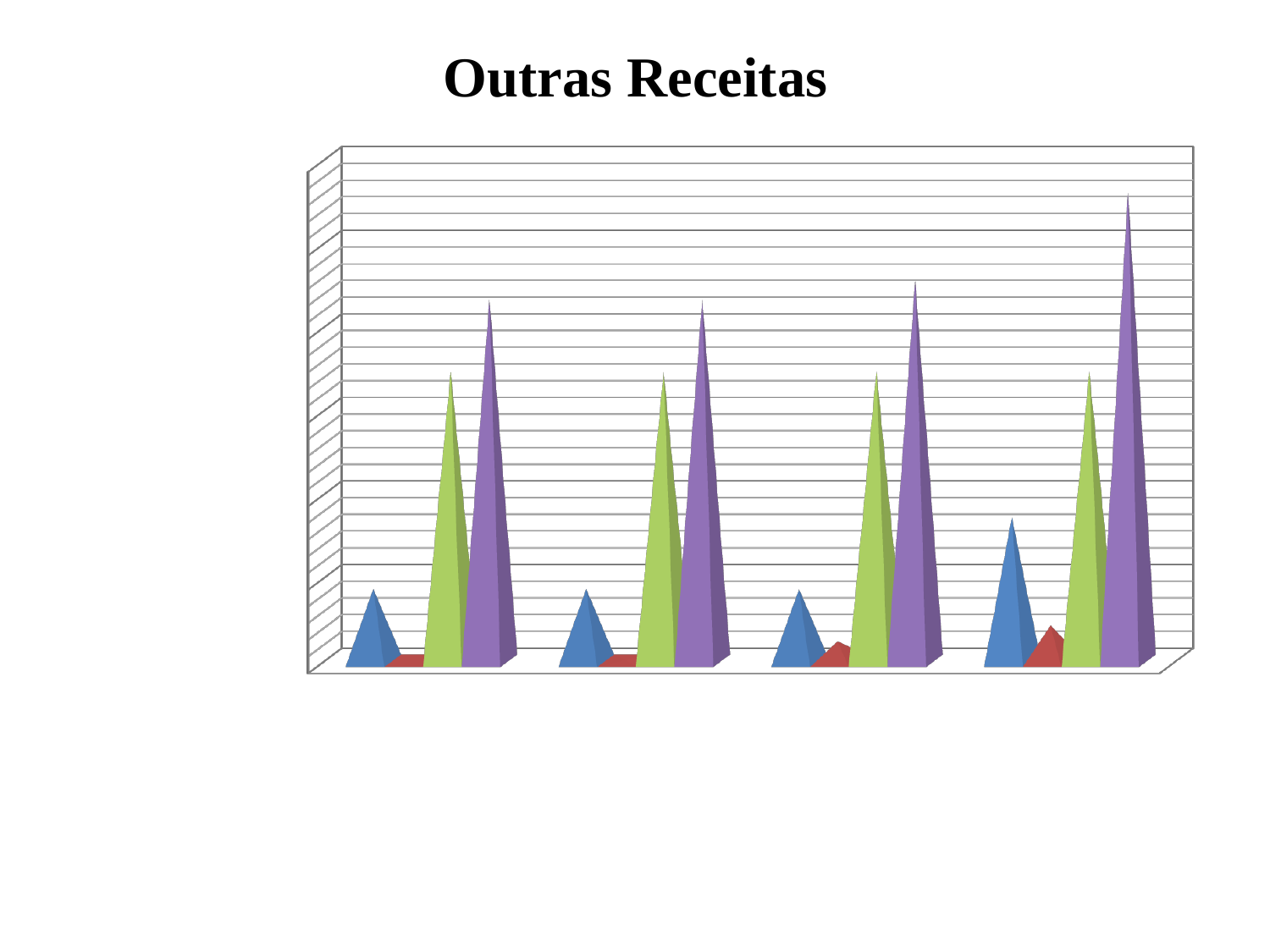
Which coloured series has the shortest bar in the leftmost group? red What kind of chart is shown on the slide? bar chart Which coloured series has the tallest bar in the rightmost group? purple In the third group from the left, which is taller: the blue bar or the green bar? green In the rightmost group, which is taller: the blue bar or the red bar? blue Do the purple bars rise or fall from left to right across the groups? rise In the leftmost group, which is taller: the green bar or the purple bar? purple What is the title of the chart? Outras Receitas How many groups of bars are plotted along the x axis? 4 Which group has the tallest purple bar? the rightmost group How many differently coloured series are plotted in each group? 4 Which group has the tallest blue bar? the rightmost group